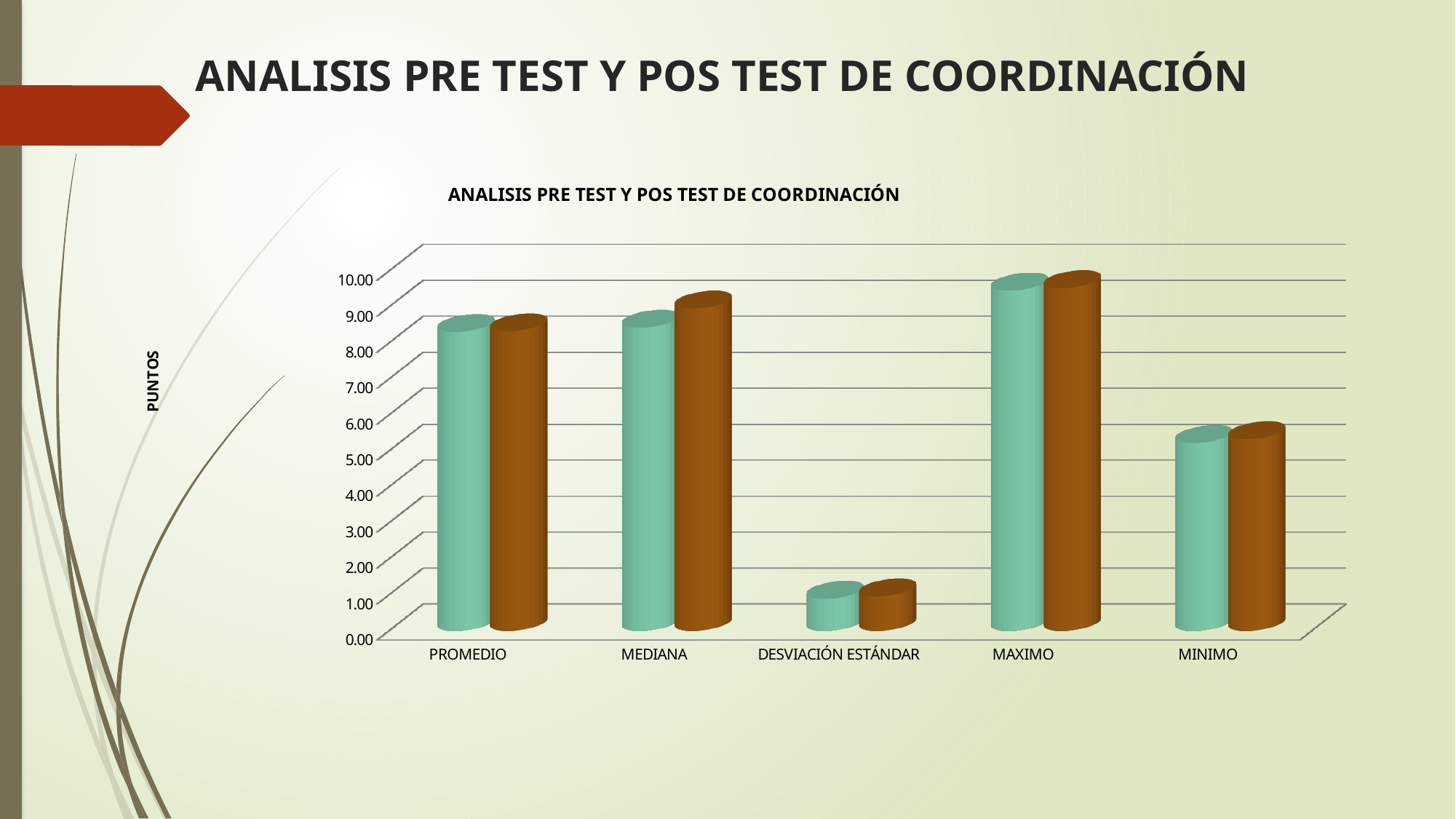
Is the teal bar for MINIMO greater or less than 7.00? less Is the brown bar for MAXIMO greater or less than 9.00? greater Is the teal bar for PROMEDIO greater or less than 7.00? greater Which category has the lowest bars in the chart? DESVIACIÓN ESTÁNDAR What is the title of the chart? ANALISIS PRE TEST Y POS TEST DE COORDINACIÓN How many categories are shown on the x axis of the chart? 5 Which is larger, the teal bar for MAXIMO or the teal bar for MINIMO? MAXIMO Which category has the highest bars in the chart? MAXIMO What is the label on the vertical axis of the chart? PUNTOS What kind of chart is shown on the slide? bar chart